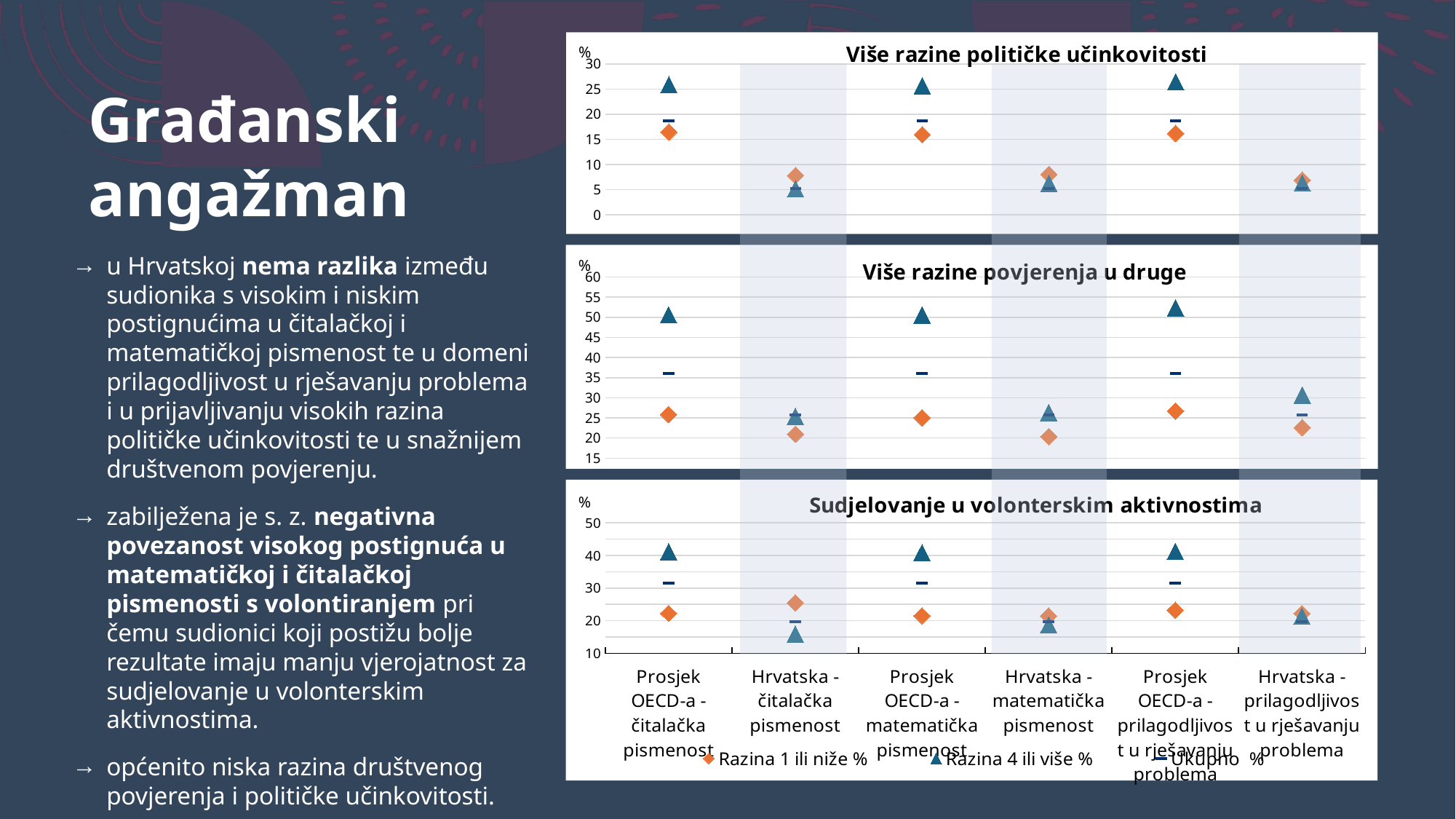
In the top chart 'Više razine političke učinkovitosti', is the value of 'Razina 1 ili niže %' for 'Prosjek OECD-a - čitalačka pismenost' greater or less than 20? less How many series does the legend list for the charts? 3 In the middle chart 'Više razine povjerenja u druge', is the value of 'Razina 4 ili više %' for 'Prosjek OECD-a - matematička pismenost' greater or less than 40? greater In the top chart 'Više razine političke učinkovitosti', is the value of 'Razina 4 ili više %' for 'Prosjek OECD-a - čitalačka pismenost' greater or less than 20? greater How many charts are shown on the slide? 3 What is the title of the top chart? Više razine političke učinkovitosti In the top chart 'Više razine političke učinkovitosti', for 'Prosjek OECD-a - čitalačka pismenost', which series has the larger value: 'Razina 1 ili niže %' or 'Razina 4 ili više %'? Razina 4 ili više % How many categories are shown along the x axis of the bottom chart 'Sudjelovanje u volonterskim aktivnostima'? 6 In the bottom chart 'Sudjelovanje u volonterskim aktivnostima', for 'Hrvatska - čitalačka pismenost', which series has the larger value: 'Razina 1 ili niže %' or 'Razina 4 ili više %'? Razina 1 ili niže %